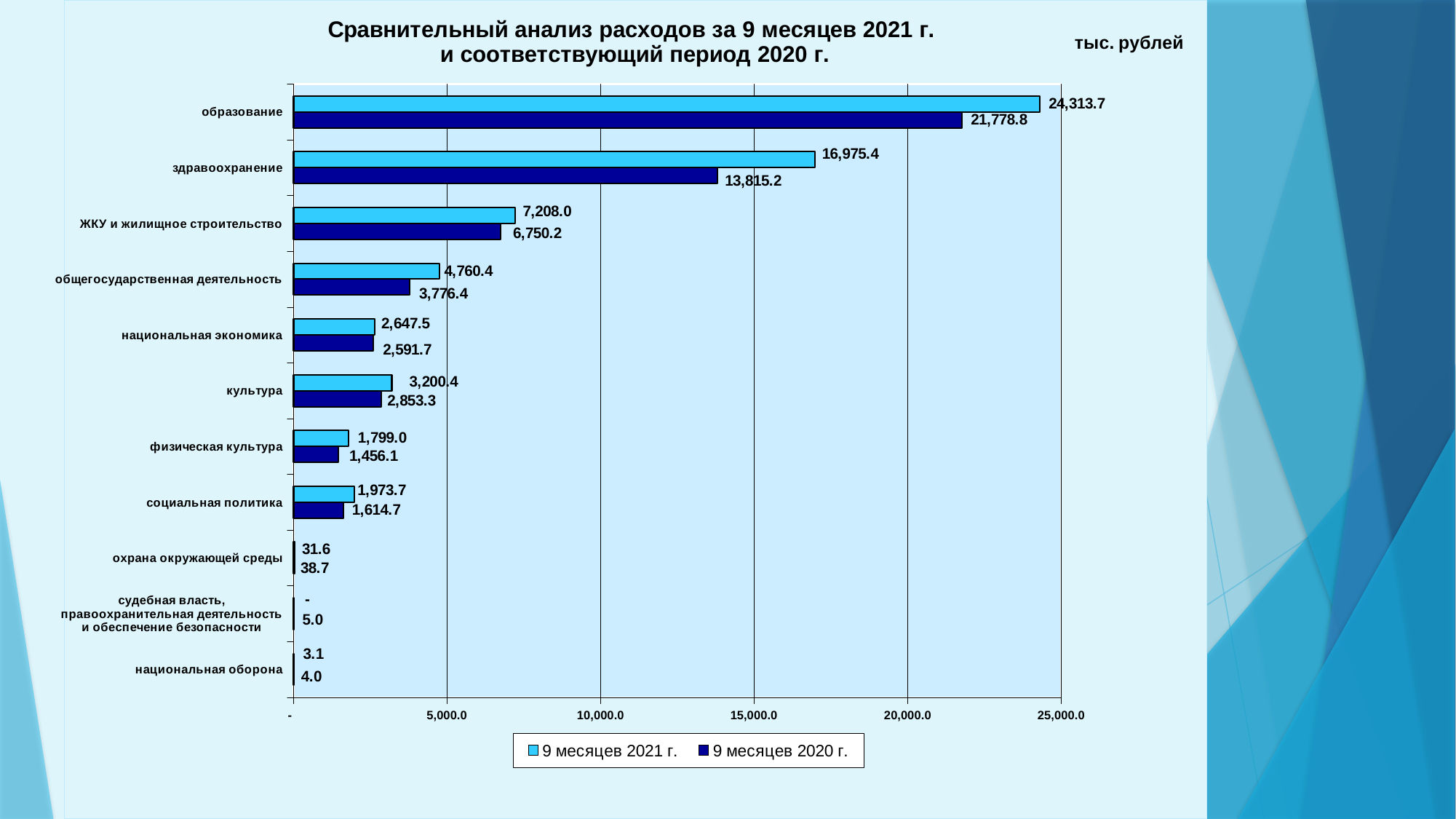
How many series does the legend list? 2 What kind of chart is shown on the slide? bar chart How many categories are shown on the chart? 11 Which category has the lowest value in the series 9 месяцев 2020 г.? национальная оборона Is the value for ЖКУ и жилищное строительство in the series 9 месяцев 2021 г. greater or less than 5,000.0? greater What is the value for образование in the series 9 месяцев 2021 г.? 24,313.7 For охрана окружающей среды, which series has the larger value: 9 месяцев 2021 г. or 9 месяцев 2020 г.? 9 месяцев 2020 г. What is the value for культура in the series 9 месяцев 2021 г.? 3,200.4 What is the difference between the 9 месяцев 2021 г. and 9 месяцев 2020 г. values for здравоохранение? 3,160.2 What is the difference between the 9 месяцев 2021 г. and 9 месяцев 2020 г. values for образование? 2,534.9 Which category has the highest value in the series 9 месяцев 2021 г.? образование What is the value for здравоохранение in the series 9 месяцев 2020 г.? 13,815.2